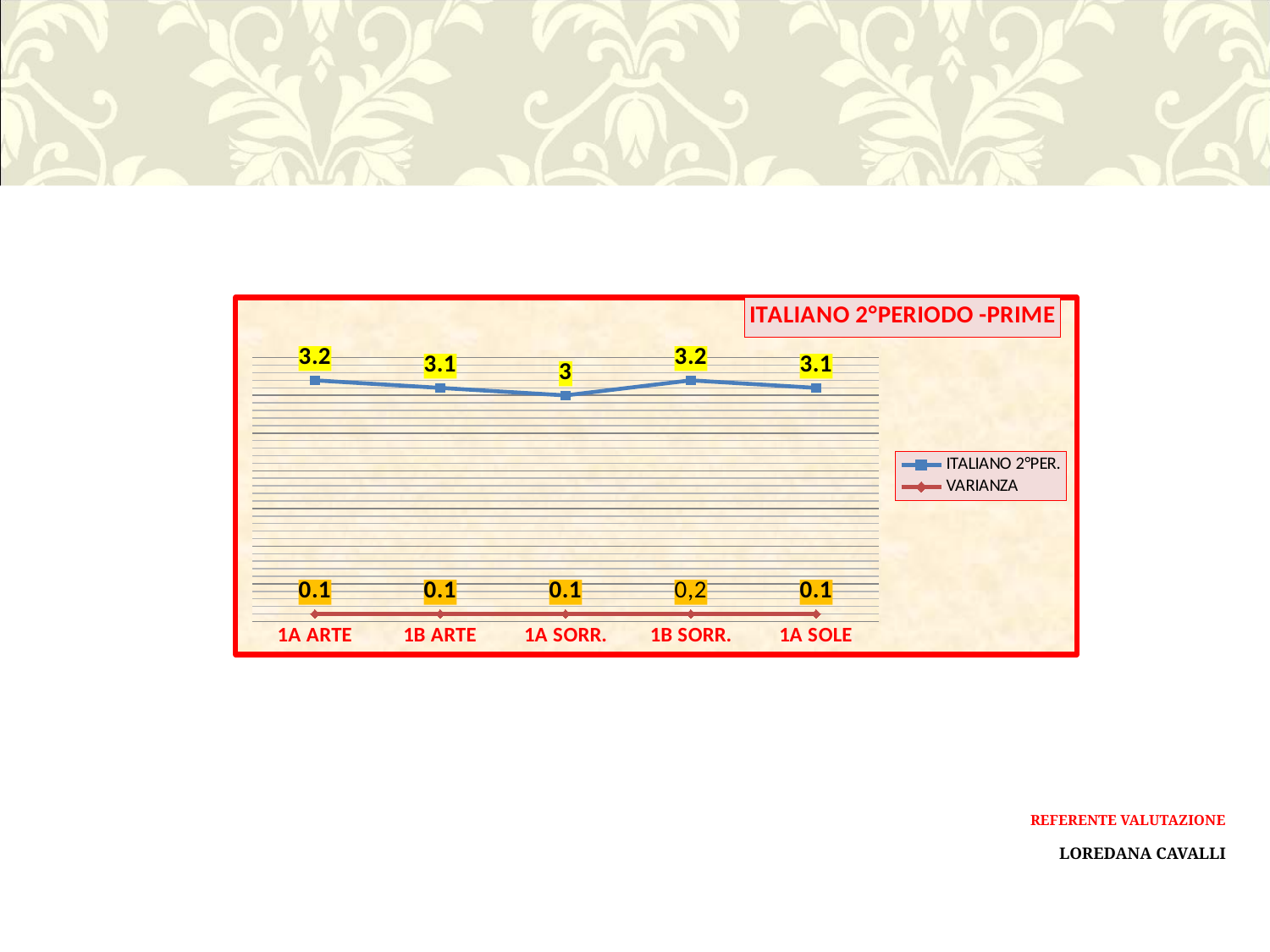
What is the title of the chart? ITALIANO 2°PERIODO -PRIME What type of chart is shown on the slide? line chart What is the difference between the ITALIANO 2°PER. values for 1A ARTE and 1A SORR.? 0.2 Which is larger, the ITALIANO 2°PER. value for 1B SORR. or for 1A SOLE? 1B SORR. Which category has the lowest ITALIANO 2°PER. value? 1A SORR. What is the VARIANZA value for 1B SORR.? 0,2 How many categories are shown on the x axis? 5 What is the ITALIANO 2°PER. value for 1A SORR.? 3 What is the VARIANZA value for 1A SOLE? 0.1 How many series does the legend list? 2 What is the ITALIANO 2°PER. value for 1A ARTE? 3.2